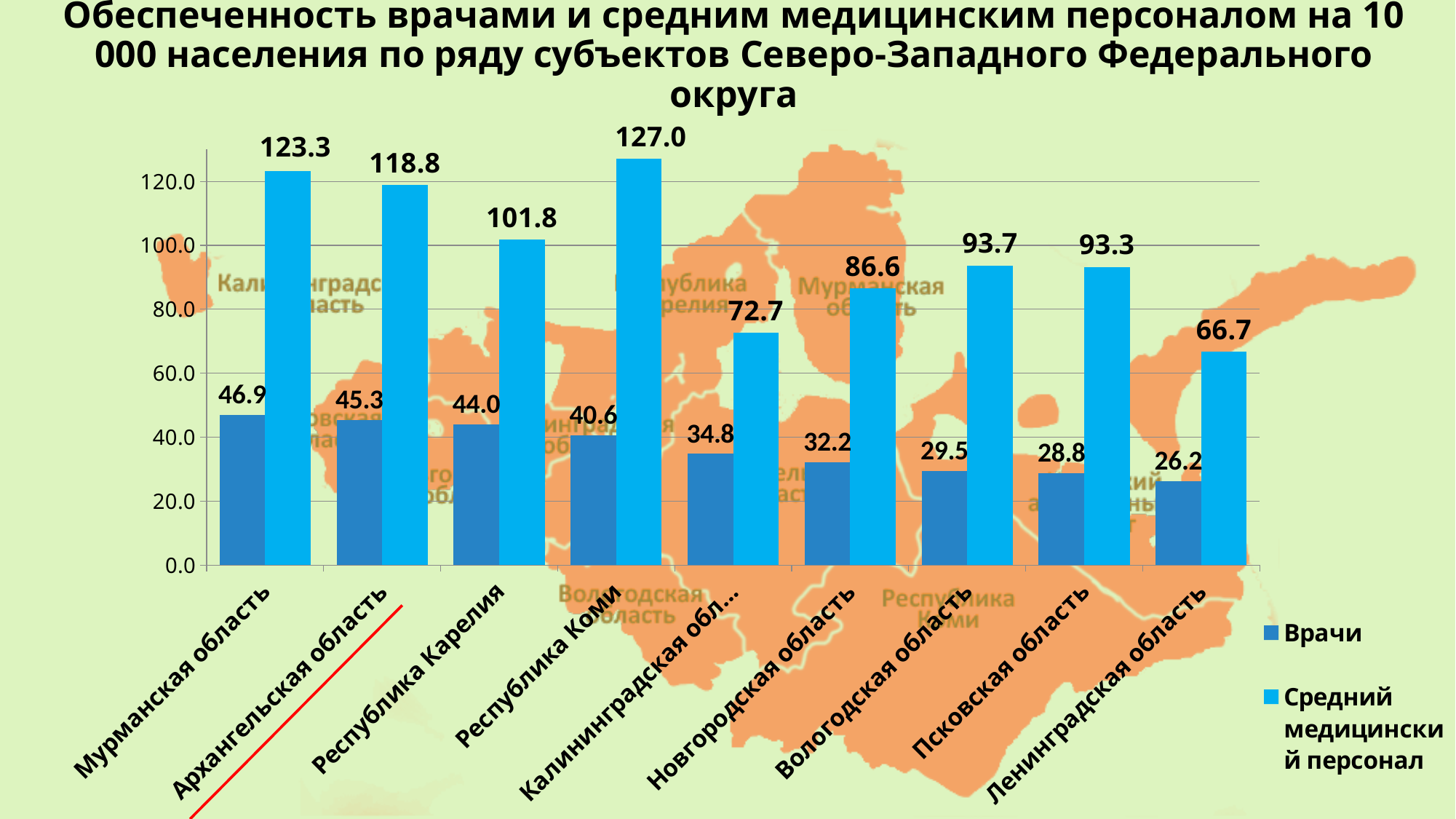
What is the difference between the Средний медицинский персонал values for Мурманская область and Архангельская область? 4.5 What is the value for Средний медицинский персонал in Новгородская область? 86.6 How many regions are shown on the x axis? 9 What kind of chart is shown on the slide? bar chart What is the value for Средний медицинский персонал in Республика Коми? 127.0 Which region has the highest value for Средний медицинский персонал? Республика Коми Which region has the lowest value for Врачи? Ленинградская область What is the value for Врачи in Мурманская область? 46.9 Do the Врачи values rise or fall from left to right along the x axis? fall Is the value for Средний медицинский персонал in Ленинградская область greater or less than 80.0? less How many series does the legend list? 2 Which is larger: the Врачи value for Республика Карелия or for Республика Коми? Республика Карелия